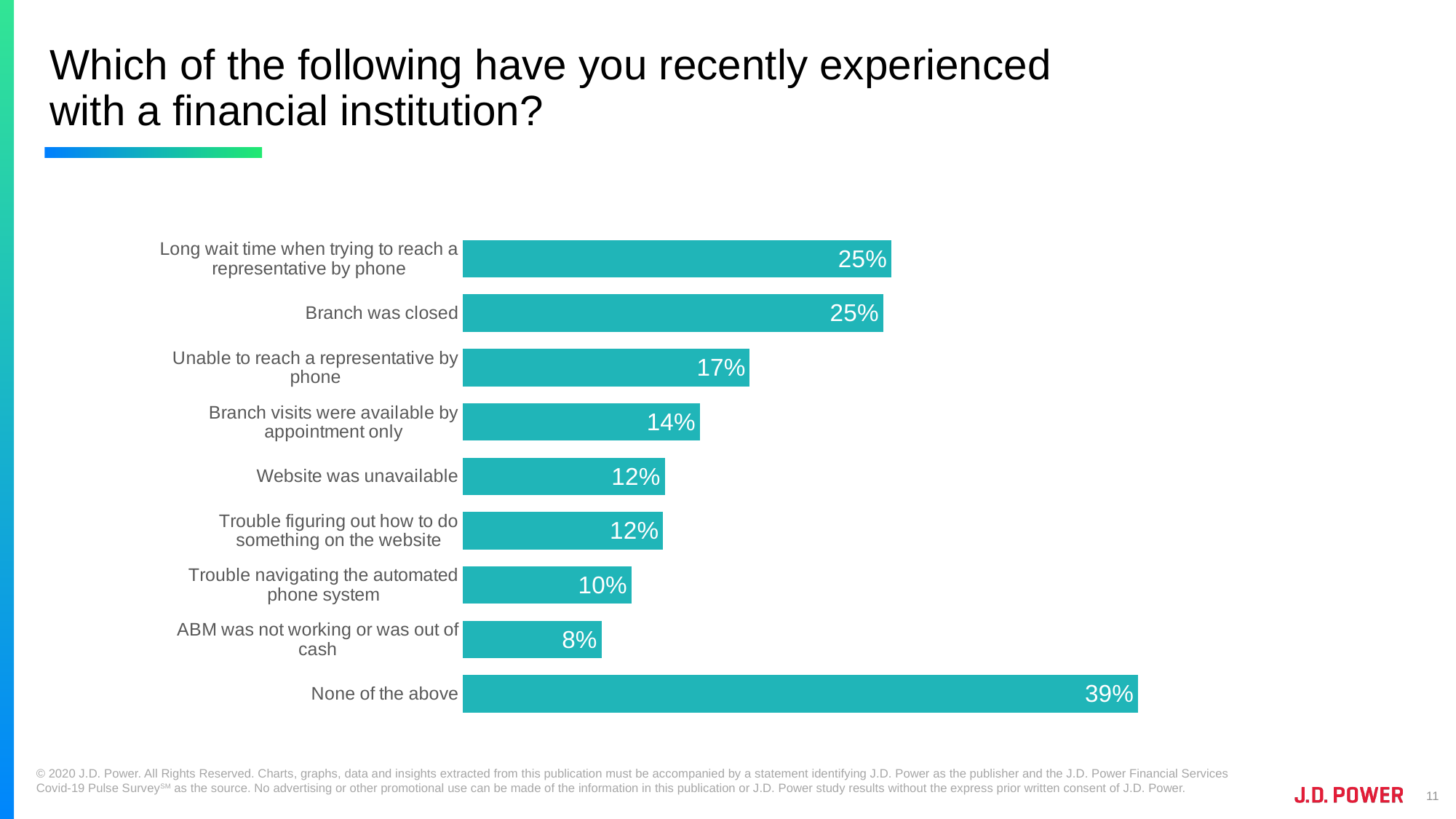
Which category has the highest value? None of the above What is the value for 'Website was unavailable'? 12% What is the difference between 'None of the above' and 'Branch was closed'? 14% What is the difference between 'Unable to reach a representative by phone' and 'Trouble navigating the automated phone system'? 7% Which category has the lowest value? ABM was not working or was out of cash What is the value for 'Branch visits were available by appointment only'? 14% What percentage reported that the ABM was not working or was out of cash? 8% What percentage of respondents said the branch was closed? 25% Which is larger: 'Unable to reach a representative by phone' or 'Website was unavailable'? Unable to reach a representative by phone How many categories are shown in the chart? 9 What kind of chart is shown on the slide? Bar chart What colour are the bars in the chart? Teal